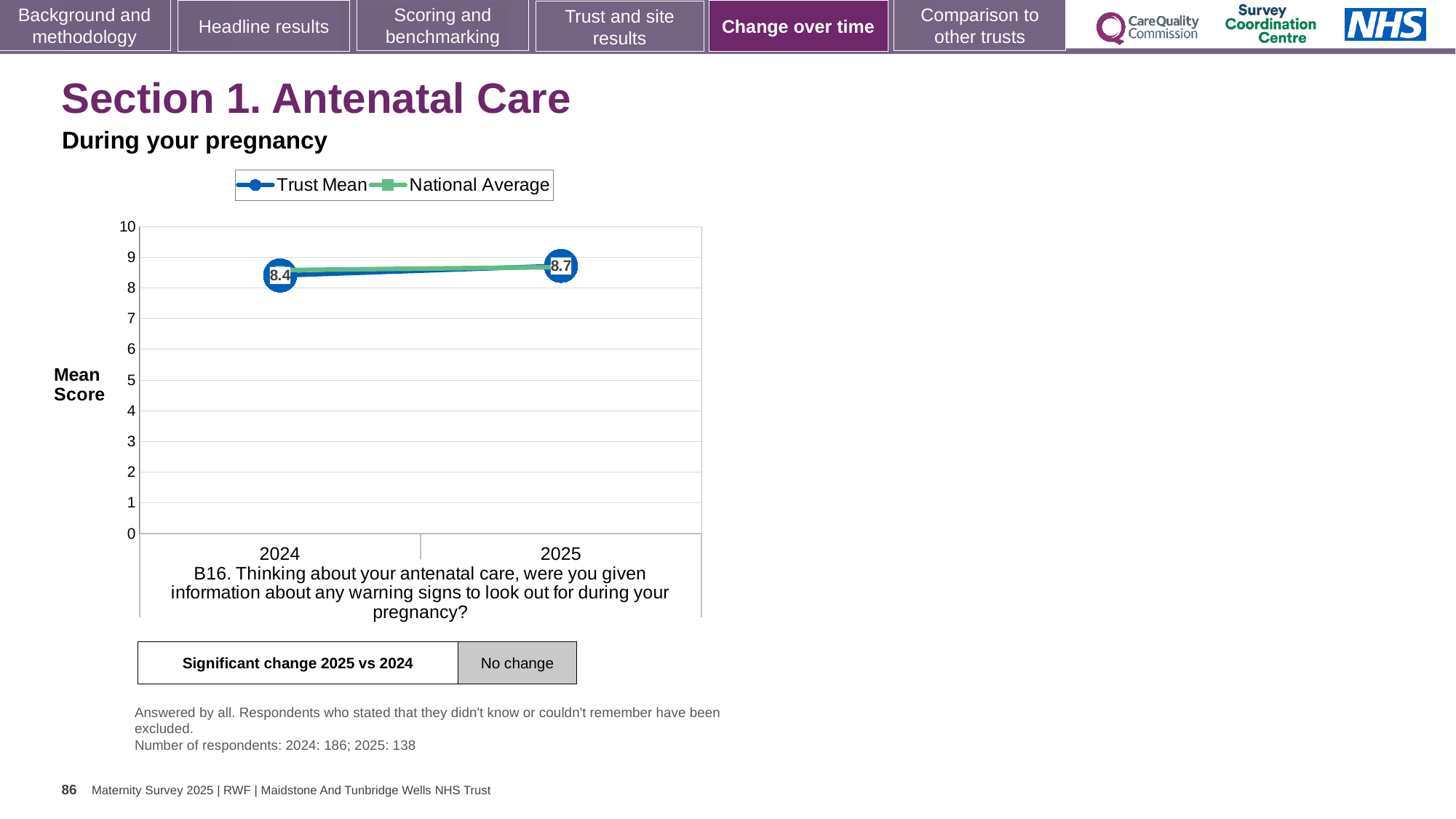
By how much did the Trust Mean change from 2024 to 2025? 0.3 In which year is the Trust Mean at its lowest? 2024 Which year has the higher Trust Mean score, 2024 or 2025? 2025 Is the National Average value for 2024 greater or less than 8? greater Does the Trust Mean rise or fall from 2024 to 2025? rise What is the Trust Mean score for 2025? 8.7 How many series does the legend list? 2 What are the two series named in the legend? Trust Mean and National Average What is the Trust Mean score for 2024? 8.4 What kind of chart is shown on the slide? line chart What is the label on the y axis of the chart? Mean Score How many years are plotted on the x axis? 2